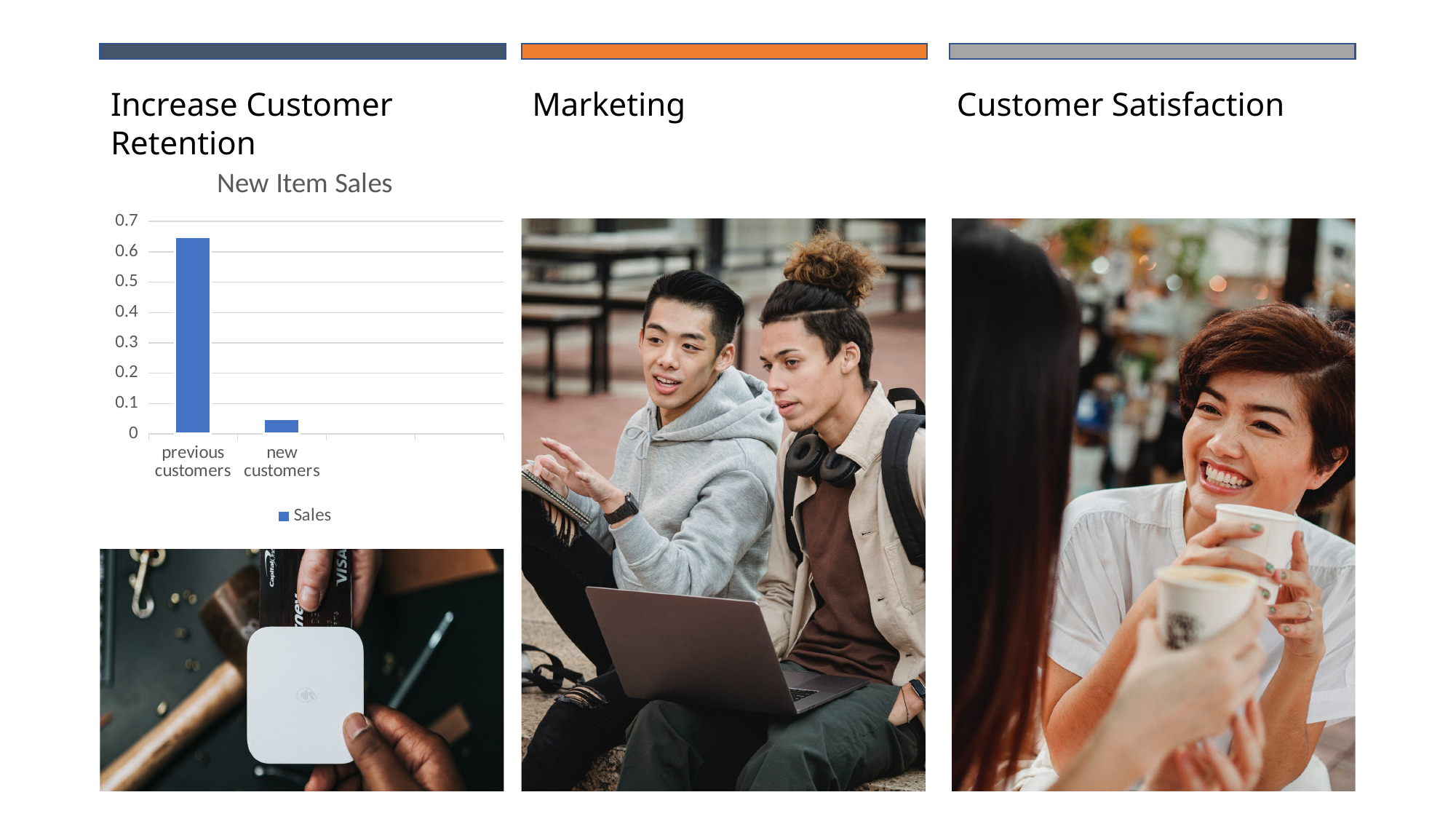
In the New Item Sales chart, is the value for previous customers greater or less than 0.5? greater Do the values in the New Item Sales chart rise or fall from previous customers to new customers? fall How many categories are plotted in the New Item Sales chart? 2 In the New Item Sales chart, is the value for new customers greater or less than 0.1? less What is the name of the series shown in the legend of the New Item Sales chart? Sales What is the title of the chart on the slide? New Item Sales In the New Item Sales chart, which category has the lowest value? new customers How many series does the legend of the New Item Sales chart list? 1 What kind of chart is shown under the heading "Increase Customer Retention"? bar chart In the New Item Sales chart, which category has the highest value? previous customers In the New Item Sales chart, which is larger: the value for previous customers or the value for new customers? previous customers In the New Item Sales chart, is the value for previous customers greater or less than 0.7? less